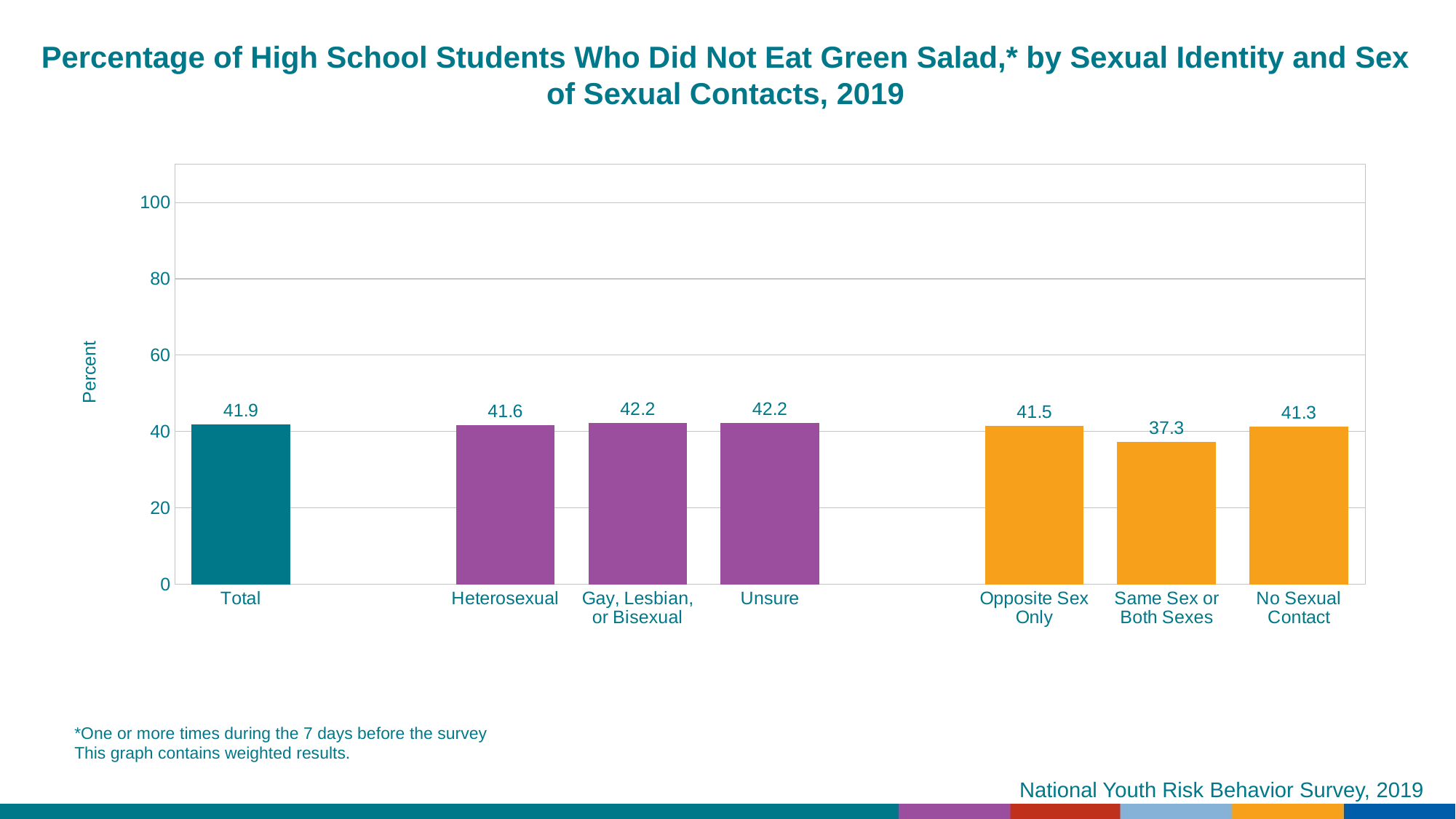
What is the value for Same Sex or Both Sexes? 37.3 Which category has the lowest value? Same Sex or Both Sexes What is the value for No Sexual Contact? 41.3 Which is larger, the value for Unsure or the value for Same Sex or Both Sexes? Unsure What is the value for Heterosexual? 41.6 How many categories are shown on the chart? 7 What is the value for Total? 41.9 Is the value for Gay, Lesbian, or Bisexual greater or less than 60? less What kind of chart is shown on the slide? bar chart What is the difference between the values for Total and Heterosexual? 0.3 What is the label of the y axis? Percent What is the difference between the values for Opposite Sex Only and Same Sex or Both Sexes? 4.2